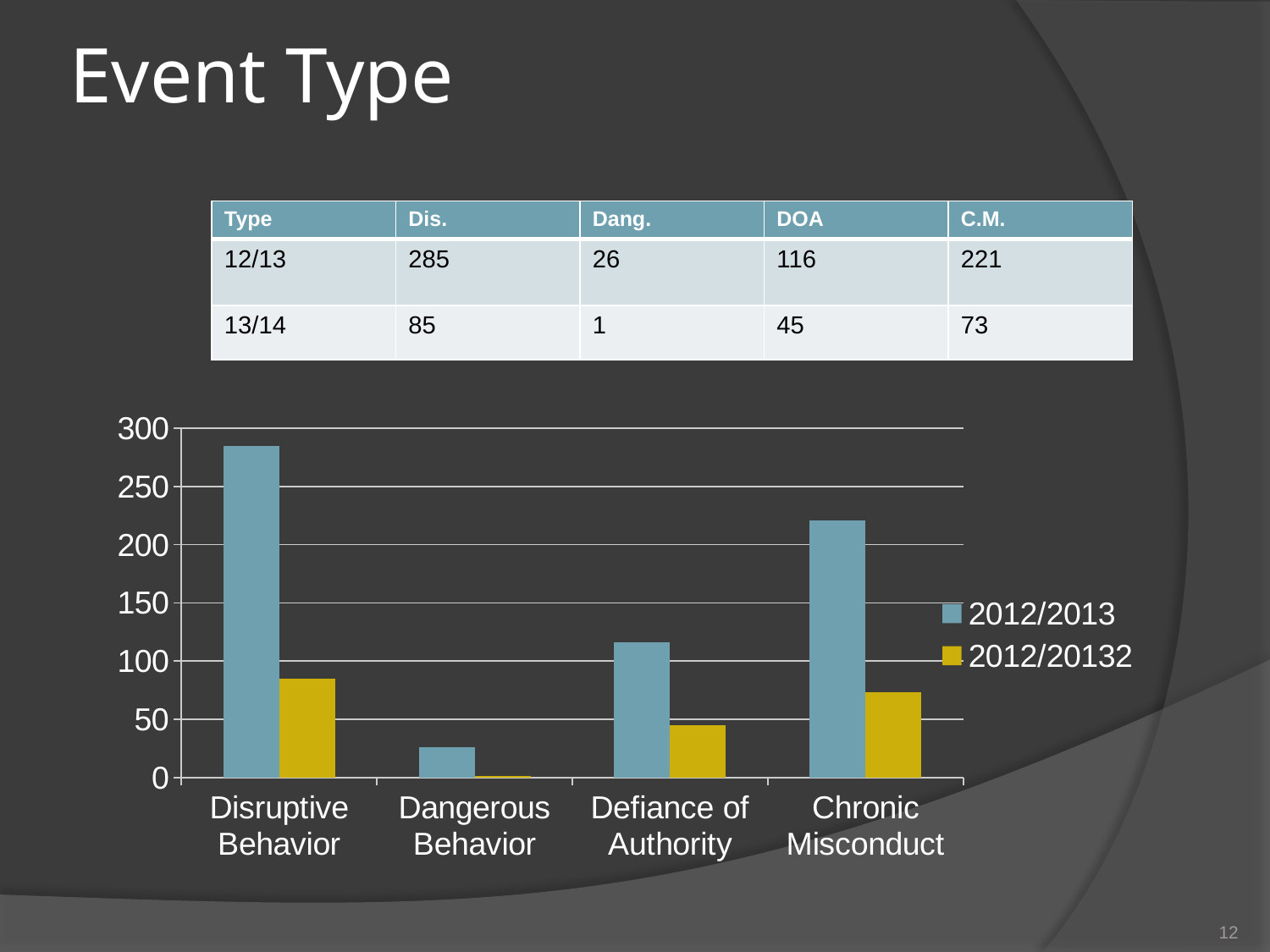
How many series does the chart's legend list? 2 Is the 2012/2013 value for Defiance of Authority greater or less than 150? less Which is larger for Chronic Misconduct: the 2012/2013 bar or the 2012/20132 bar? 2012/2013 According to the table on the slide, what is the difference between the 12/13 and 13/14 values for C.M.? 148 Which category has the lowest 2012/2013 bar? Dangerous Behavior What kind of chart is shown on the slide? bar chart Is the 2012/2013 value for Chronic Misconduct greater or less than 200? greater Is the 2012/20132 value for Disruptive Behavior greater or less than 100? less What are the two entries in the chart's legend? 2012/2013 and 2012/20132 According to the table on the slide, what is the 12/13 value for Dis. (Disruptive Behavior)? 285 Which category has the highest 2012/2013 bar? Disruptive Behavior How many categories are shown on the x axis of the chart? 4